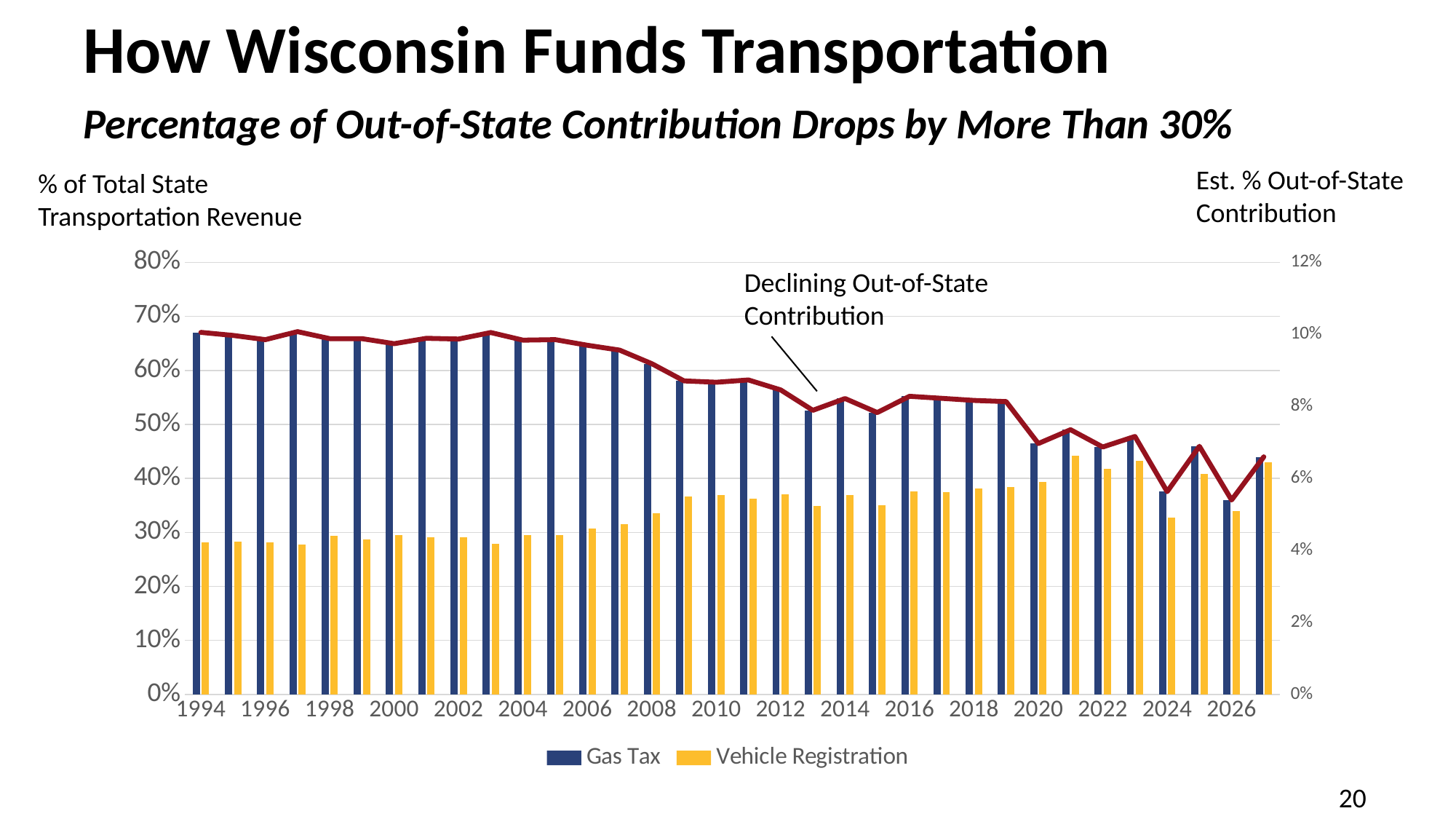
In 1994, which is larger: Gas Tax or Vehicle Registration? Gas Tax What colour are the Gas Tax bars? dark blue In 2010, which is larger: Gas Tax or Vehicle Registration? Gas Tax Which two series are listed in the legend? Gas Tax and Vehicle Registration Do the Vehicle Registration values generally rise or fall from 1994 to 2027? rise Is the Vehicle Registration value for 2021 greater or less than 40%? greater How many series does the legend list? 2 What kind of chart is shown on the slide? combination bar and line chart Is the Gas Tax value for 2020 greater or less than 50%? less Is the Gas Tax value for 1994 greater or less than 60%? greater Do the Gas Tax values generally rise or fall from 1994 to 2027? fall